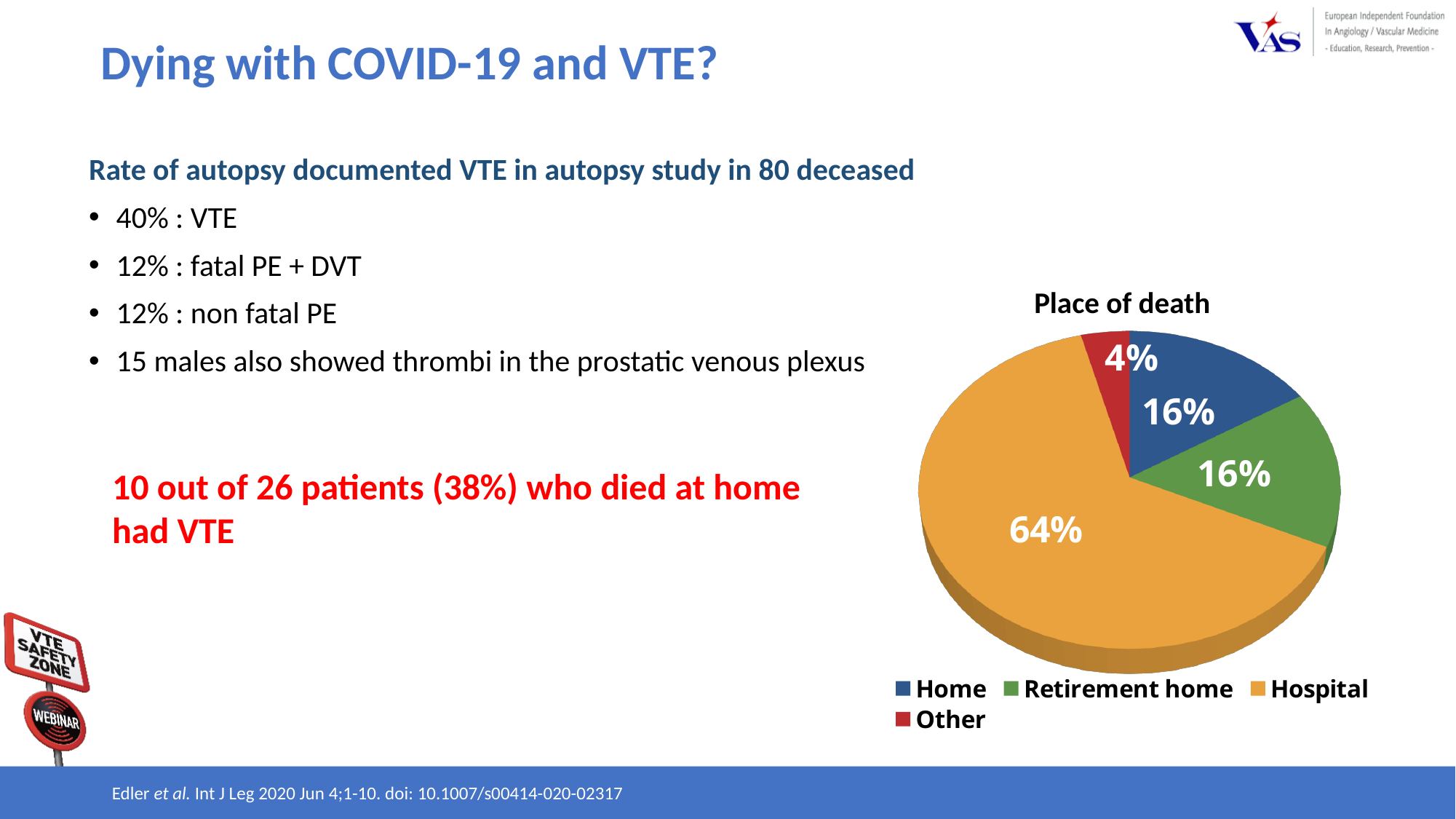
Which colour represents Hospital in the pie chart? Orange How many categories does the pie chart show? 4 What kind of chart is shown on the slide? Pie chart What is the value for Retirement home in the pie chart? 16% What share of the pie does Hospital account for? 64% Which category has the smallest slice of the pie? Other What is the difference between the Hospital share and the Home share? 48% Which category has the largest slice of the pie? Hospital What is the title of the chart? Place of death Which is larger, the Hospital slice or the Other slice? Hospital What is the value for Other in the pie chart? 4% What is the value for Home in the pie chart? 16%